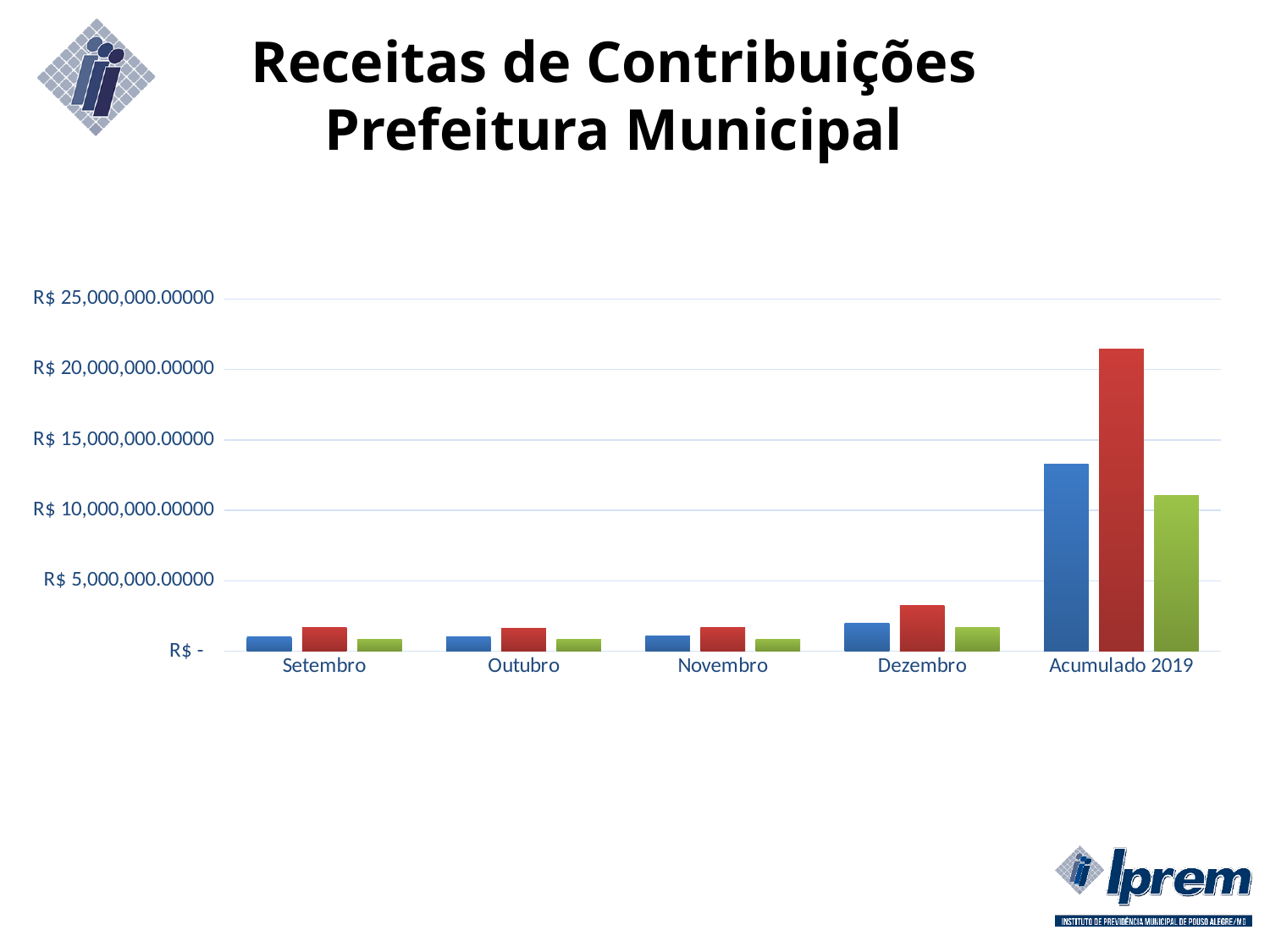
Is the value of the blue bar for Acumulado 2019 greater or less than R$ 15,000,000.00000? less For Acumulado 2019, which bar is larger, the red bar or the blue bar? the red bar Is the value of the red bar for Acumulado 2019 greater or less than R$ 20,000,000.00000? greater How many bars are plotted for each category on the x axis? 3 For Acumulado 2019, which bar is larger, the blue bar or the green bar? the blue bar For Dezembro, which bar is larger, the red bar or the green bar? the red bar Which category on the x axis has the tallest bars? Acumulado 2019 Is the value of the red bar for Dezembro greater or less than R$ 5,000,000.00000? less What is the title of the slide containing the chart? Receitas de Contribuições Prefeitura Municipal What kind of chart is shown on the slide? bar chart How many categories are shown on the x axis of the chart? 5